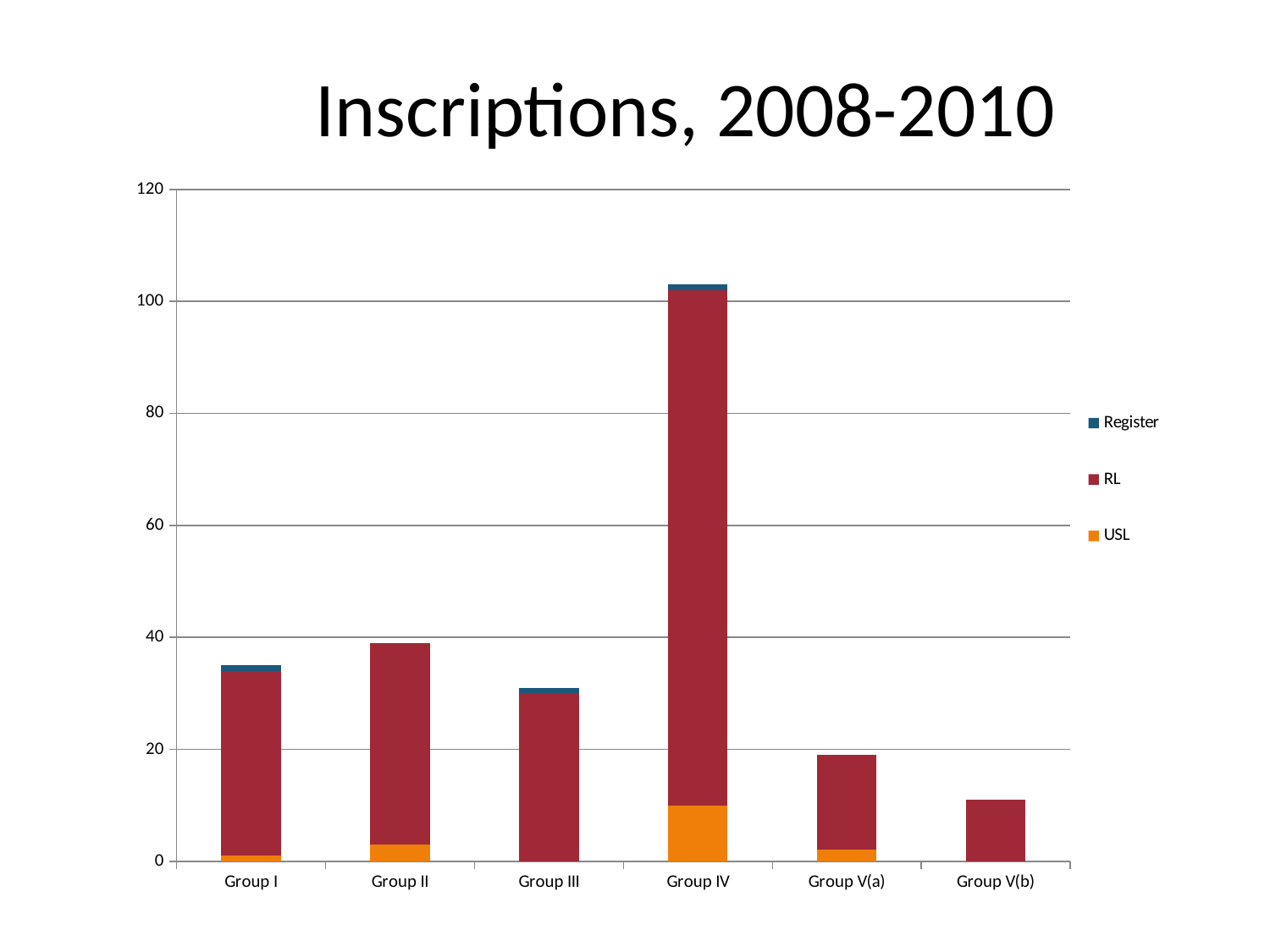
Which has the taller stacked bar, Group II or Group III? Group II Which group has the tallest stacked bar? Group IV How many series does the legend list? 3 How many groups are shown on the x axis of the chart? 6 Which group has the shortest stacked bar? Group V(b) Is the total value for Group I greater or less than 40? less What kind of chart is shown on the slide? Stacked bar chart Is the total value for Group V(b) greater or less than 20? less Is the total value for Group III greater or less than 20? greater Which series is shown in orange in the legend? USL What is the title of the chart? Inscriptions, 2008-2010